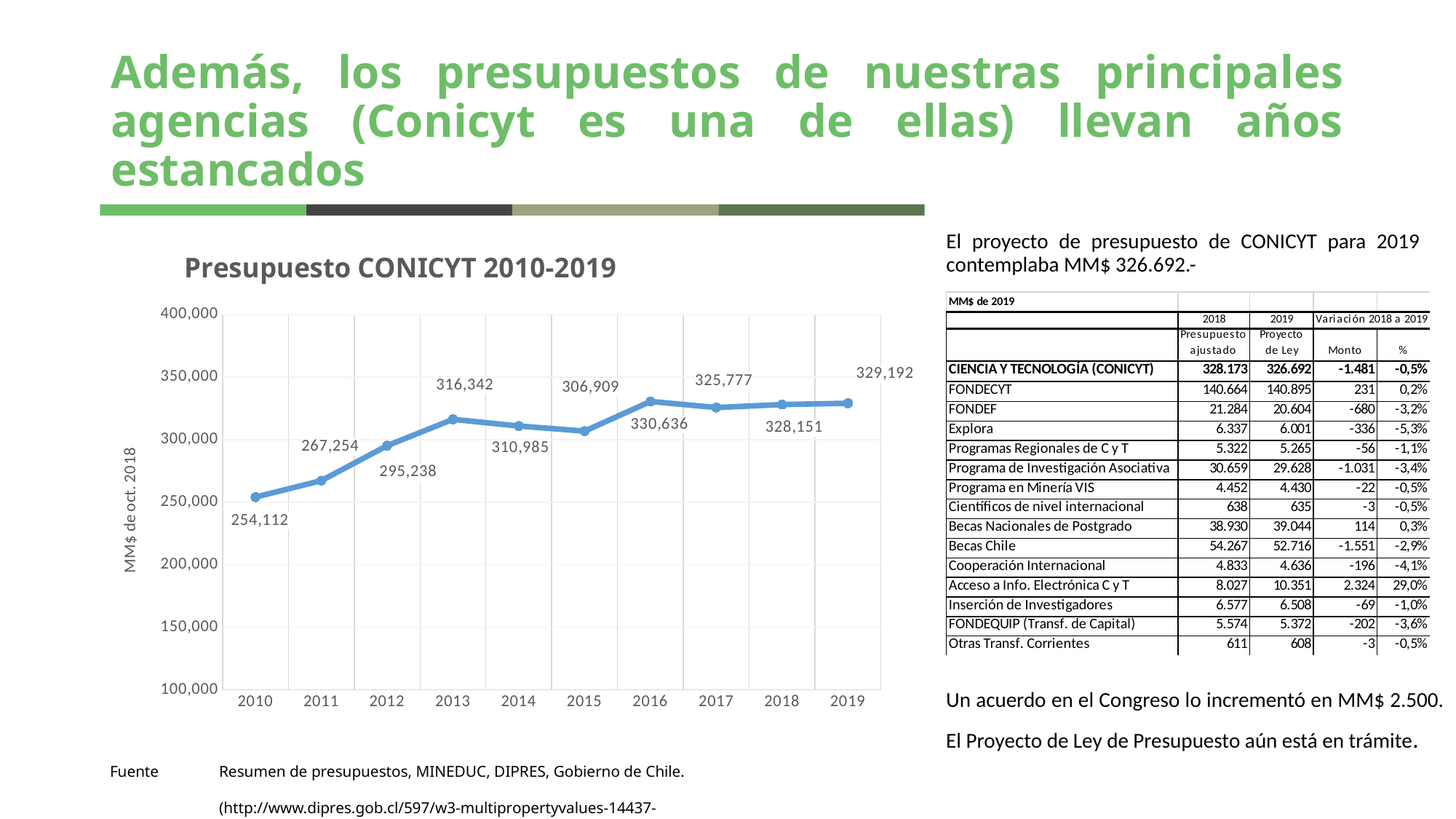
In the Presupuesto CONICYT 2010-2019 chart, which is larger, the value for 2013 or the value for 2014? 2013 What is the value for 2019 in the Presupuesto CONICYT 2010-2019 chart? 329,192 Which year has the highest value in the Presupuesto CONICYT 2010-2019 chart? 2016 How many years are plotted in the Presupuesto CONICYT 2010-2019 chart? 10 Which year has the lowest value in the Presupuesto CONICYT 2010-2019 chart? 2010 What kind of chart is the Presupuesto CONICYT 2010-2019 chart? line chart What is the y-axis label of the Presupuesto CONICYT 2010-2019 chart? MM$ de oct. 2018 What is the value for 2010 in the Presupuesto CONICYT 2010-2019 chart? 254,112 What is the difference between the 2016 and 2015 values in the Presupuesto CONICYT 2010-2019 chart? 23,727 What is the difference between the 2019 and 2010 values in the Presupuesto CONICYT 2010-2019 chart? 75,080 What is the value for 2016 in the Presupuesto CONICYT 2010-2019 chart? 330,636 Is the value for 2012 in the Presupuesto CONICYT 2010-2019 chart greater or less than 300,000? less